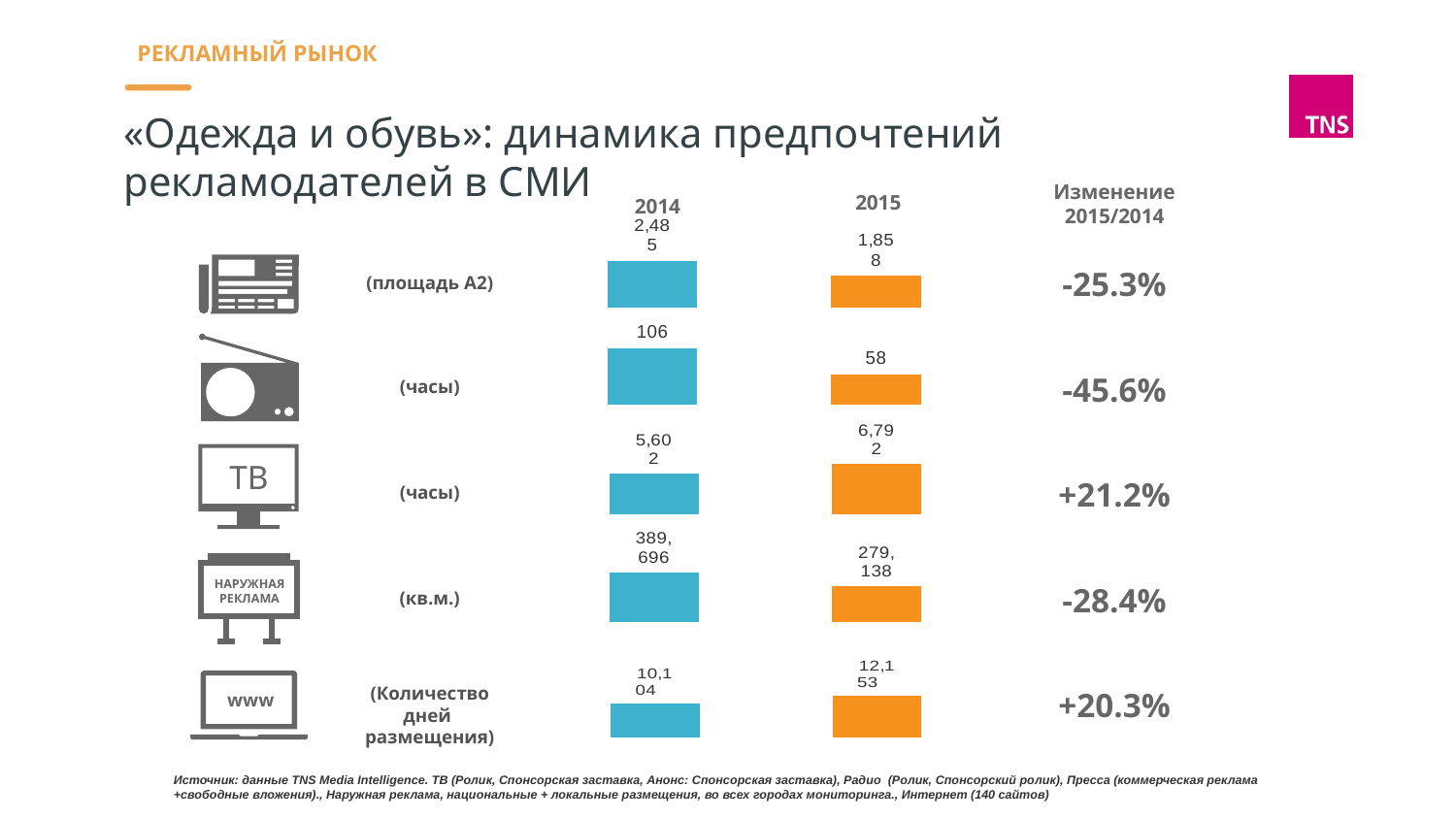
Which medium shows the largest percentage increase from 2014 to 2015? TV What is the 2014 value for internet (количество дней размещения)? 10,104 What is the change 2015/2014 shown for TV? +21.2% How many media categories are shown on the slide? 5 What is the 2014 value for TV (часы)? 5,602 Is the 2015 value for press (площадь A2) larger or smaller than its 2014 value? smaller Which medium shows the largest percentage decline from 2014 to 2015? Radio What is the change 2015/2014 shown for radio? -45.6% What is the difference between the 2014 and 2015 values for radio (часы)? 48 Which colour represents the 2015 values? Orange What is the 2015 value for outdoor advertising (кв.м.)? 279,138 What is the 2015 value for radio (часы)? 58